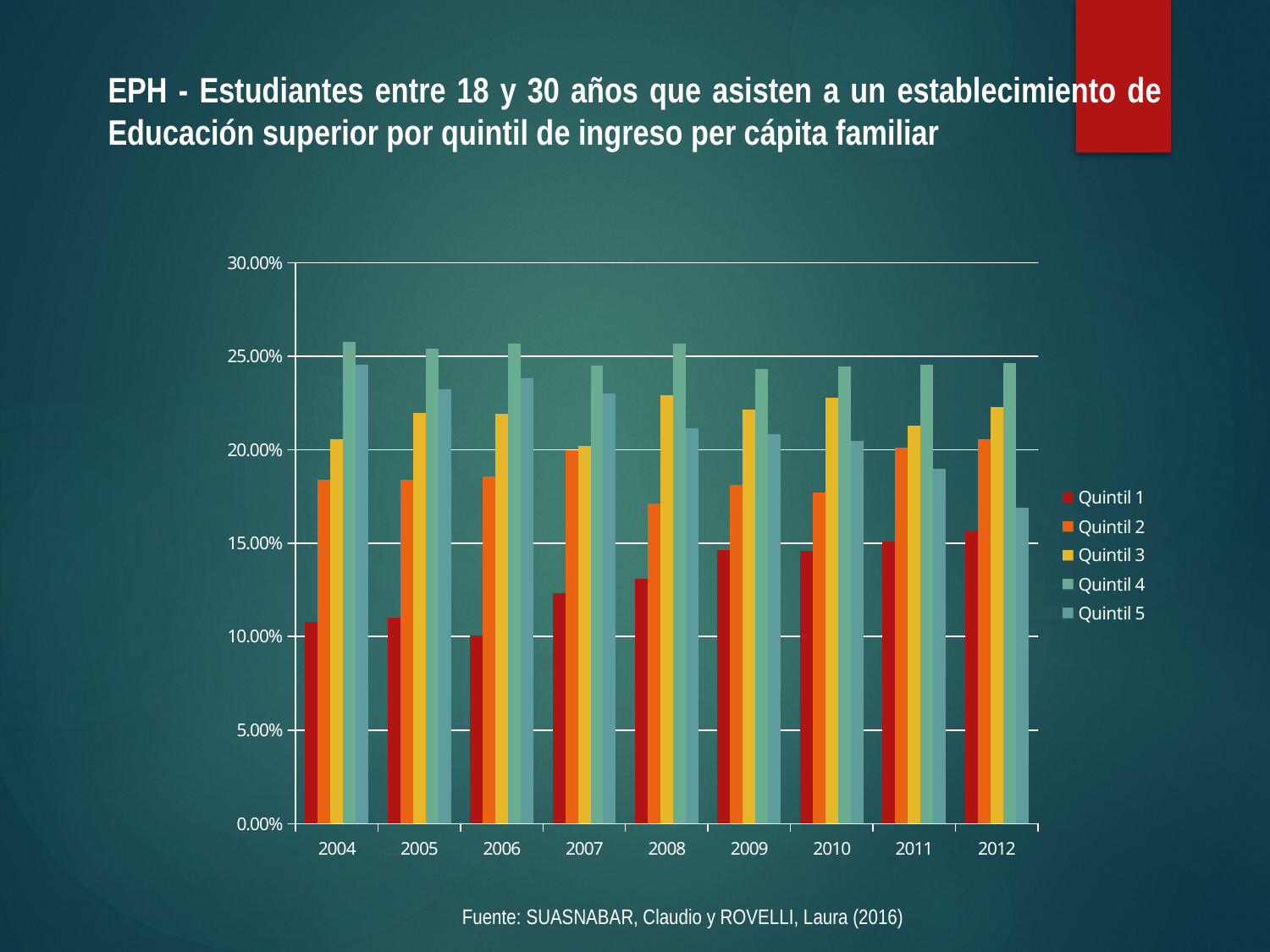
Which is larger, the value for Quintil 5 in 2004 or in 2012? 2004 How many series does the legend list? 5 What kind of chart is shown on the slide? bar chart Which quintile has the lowest value in 2004? Quintil 1 What colour are the bars for Quintil 1 in the legend? dark red Which quintile has the highest value in 2012? Quintil 4 How many years are shown on the x axis? 9 Is the value for Quintil 5 in 2012 greater or less than 20.00%? less Do the values for Quintil 5 generally rise or fall from 2004 to 2012? fall Is the value for Quintil 4 in 2004 greater or less than 25.00%? greater Which is larger, the value for Quintil 1 in 2004 or in 2012? 2012 Is the value for Quintil 1 in 2004 greater or less than 15.00%? less